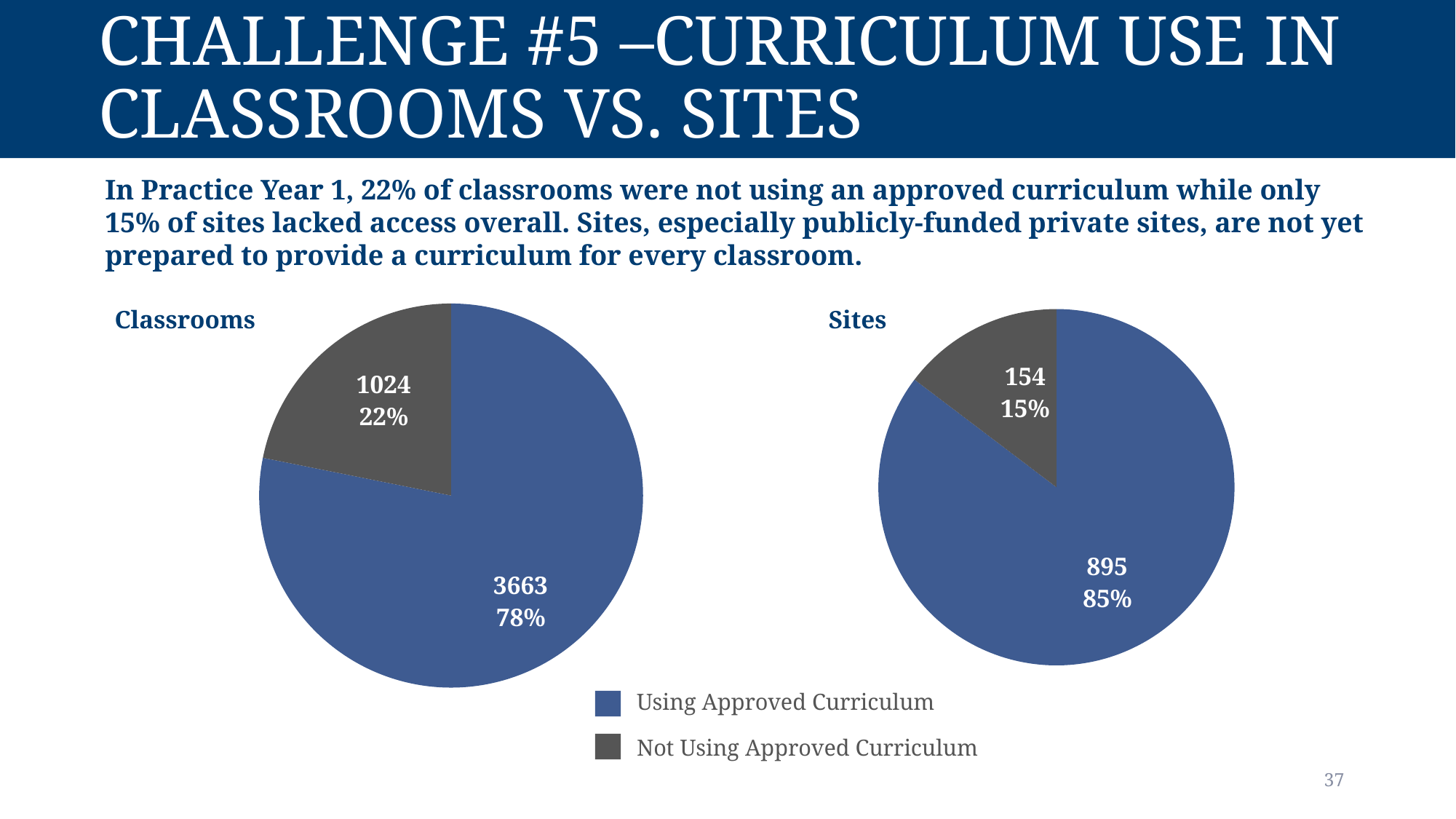
How many entries does the legend list? 2 In the Classrooms pie chart, which slice is the largest? Using Approved Curriculum What type of chart is used for the Classrooms and Sites data? Pie chart In the Sites pie chart, which slice is the smallest? Not Using Approved Curriculum In the Classrooms pie chart, how many classrooms are using an approved curriculum? 3663 In the Classrooms pie chart, what percentage of classrooms are not using an approved curriculum? 22% In the Classrooms pie chart, what is the difference between the number of classrooms using and not using an approved curriculum? 2639 In the Sites pie chart, how many sites are not using an approved curriculum? 154 Which is larger: the number of classrooms not using an approved curriculum or the number of sites using an approved curriculum? Classrooms not using an approved curriculum (1024) In the Sites pie chart, what is the total number of sites across both slices? 1049 How many slices does the Sites pie chart have? 2 In the Sites pie chart, what share of sites are using an approved curriculum? 85%